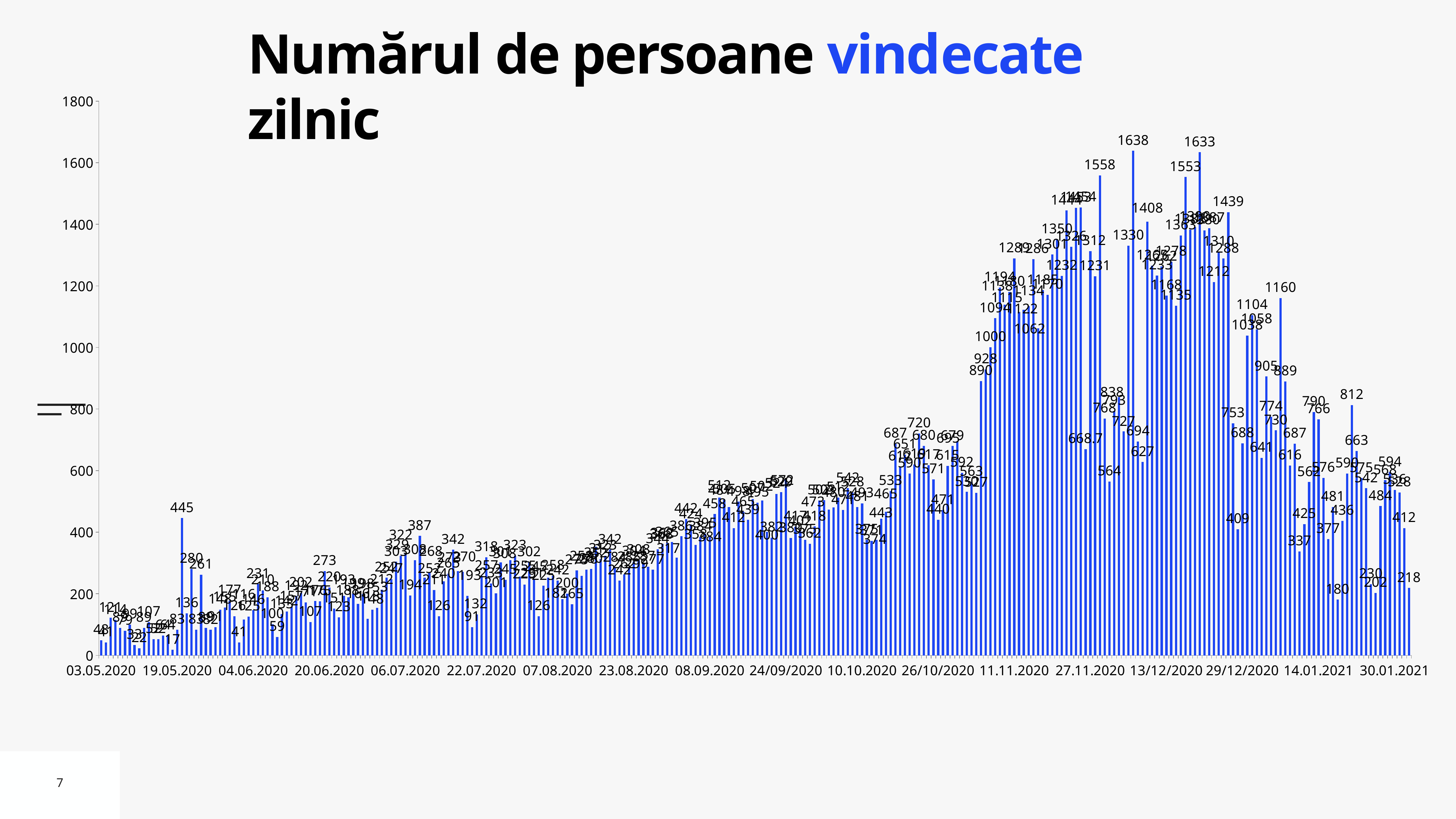
What is the title of the chart? Numărul de persoane vindecate zilnic Which is larger, the peak value 1638 or the later peak value 1553? 1638 Is the value labelled 445 near 19.05.2020 greater or less than 400? greater What is the highest daily value shown in the chart? 1638 Is the highest value in the chart greater or less than 1600? greater What kind of chart is shown on the slide? bar chart Do the values generally rise or fall from May 2020 to late November 2020? rise What is the difference between the highest value (1638) and the value 1558 shown nearby? 80 What is the highest tick value on the y axis? 1800 What is the lowest daily value labelled in the chart? 17 What is the first date label on the x axis? 03.05.2020